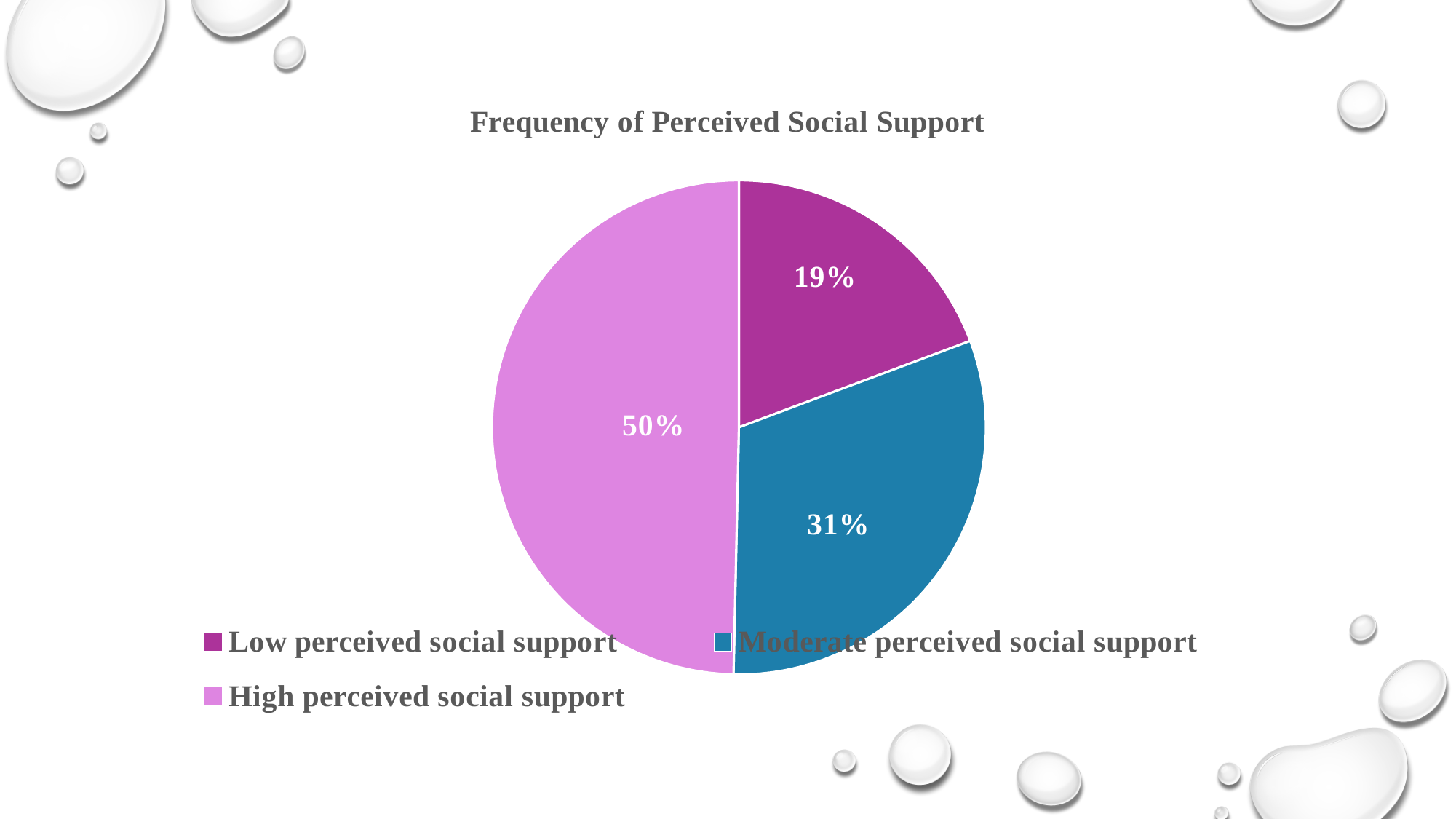
Which category has the smallest share of the pie? Low perceived social support Which category has the largest share of the pie? High perceived social support What is the difference in percentage points between High perceived social support and Moderate perceived social support? 19 What is the title of the chart? Frequency of Perceived Social Support What is the difference in percentage points between Moderate perceived social support and Low perceived social support? 12 What percentage of the pie is Moderate perceived social support? 31% What percentage of the pie is High perceived social support? 50% What percentage of the pie is Low perceived social support? 19% Which is larger, the share for Moderate perceived social support or Low perceived social support? Moderate perceived social support How many categories does the pie chart have? 3 What kind of chart is shown on the slide? pie chart What colour is the slice for Moderate perceived social support? blue